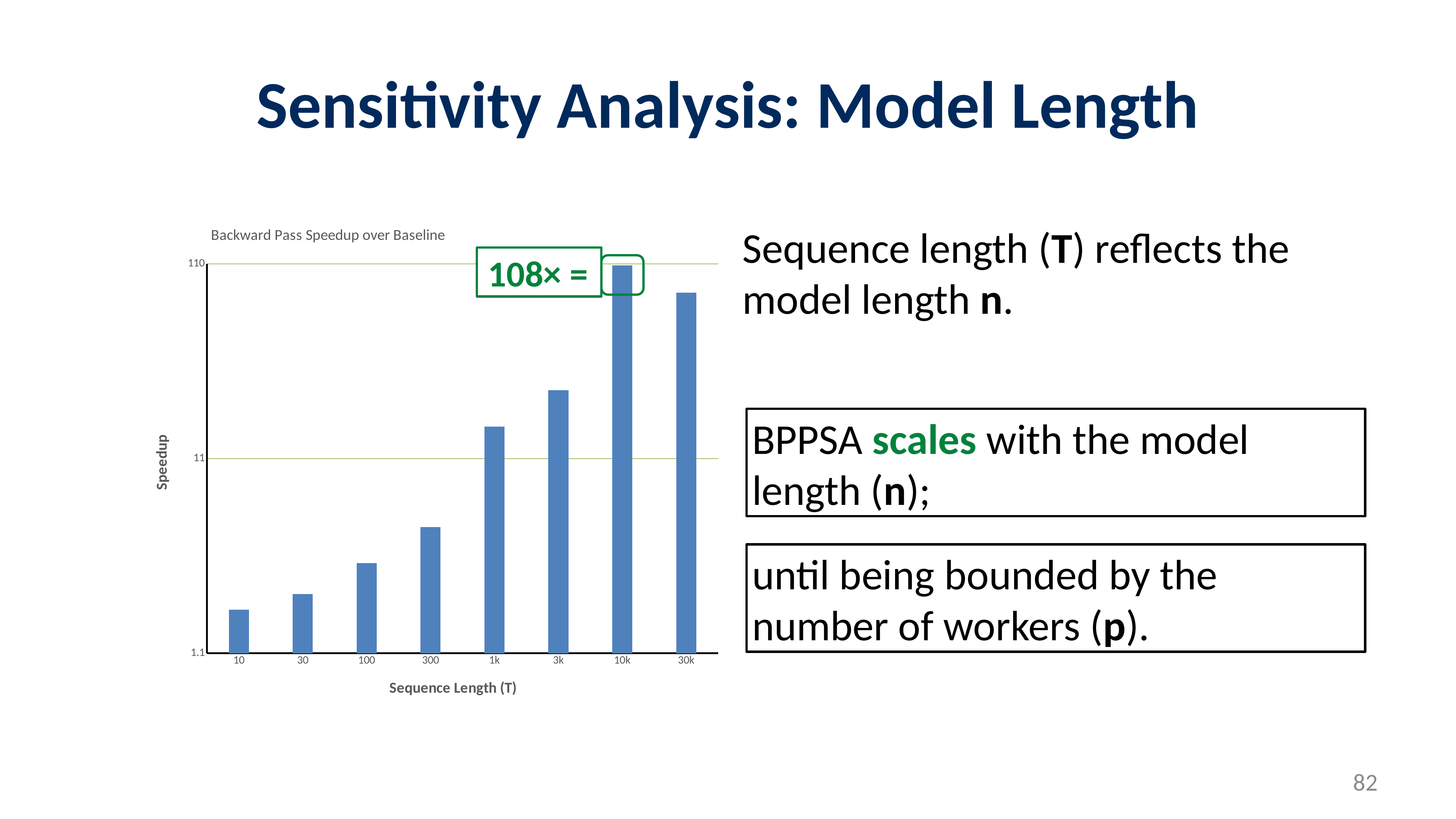
Is the speedup for sequence length 300 greater or less than 11? less Does the speedup rise or fall as sequence length increases from 10 to 10k? rise Which sequence length has the highest speedup? 10k Which sequence length has the lowest speedup? 10 What is the title of the chart? Backward Pass Speedup over Baseline Which has the larger speedup, sequence length 10k or 30k? 10k What is the label of the x axis of the chart? Sequence Length (T) What kind of chart is shown on the slide? bar chart Is the speedup for sequence length 1k greater or less than 11? greater How many sequence length categories are plotted in the chart? 8 What speedup is annotated for the sequence length 10k bar? 108× Is the speedup for sequence length 30k greater or less than 11? greater